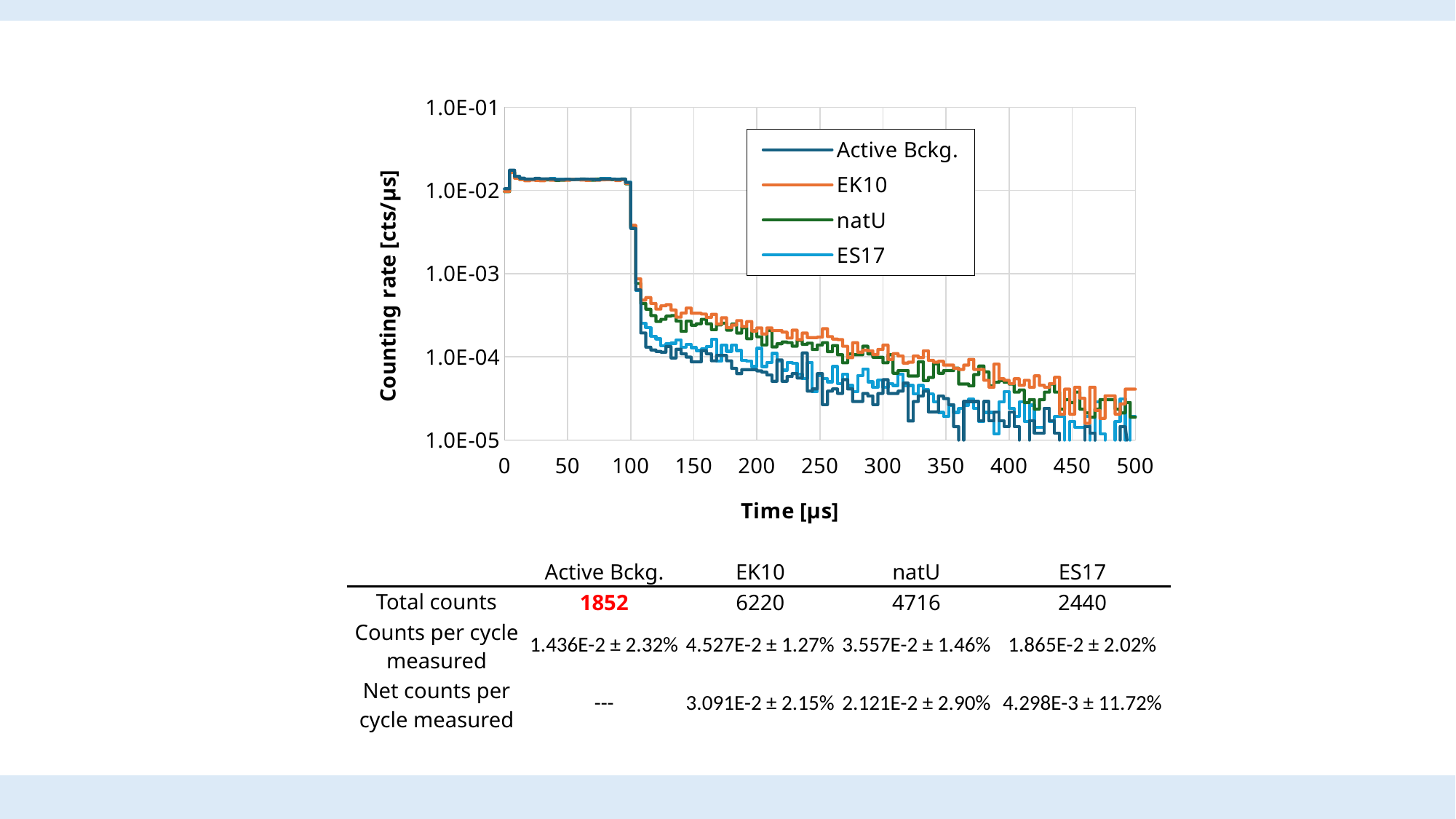
At 200 µs, is the counting rate for EK10 greater or less than 1.0E-04? greater What kind of chart is shown on the slide? line chart Which series has the highest counting rate between 150 and 300 µs? EK10 At 200 µs, which series has the larger counting rate, EK10 or Active Bckg.? EK10 At 150 µs, is the counting rate for natU greater or less than 1.0E-04? greater What is the title of the y-axis of the chart? Counting rate [cts/µs] At 250 µs, which series has the larger counting rate, natU or ES17? natU Do the counting rates rise or fall along the time axis after 100 µs? fall At 400 µs, is the counting rate for ES17 greater or less than 1.0E-04? less What is the title of the x-axis of the chart? Time [µs] How many series does the chart legend list? 4